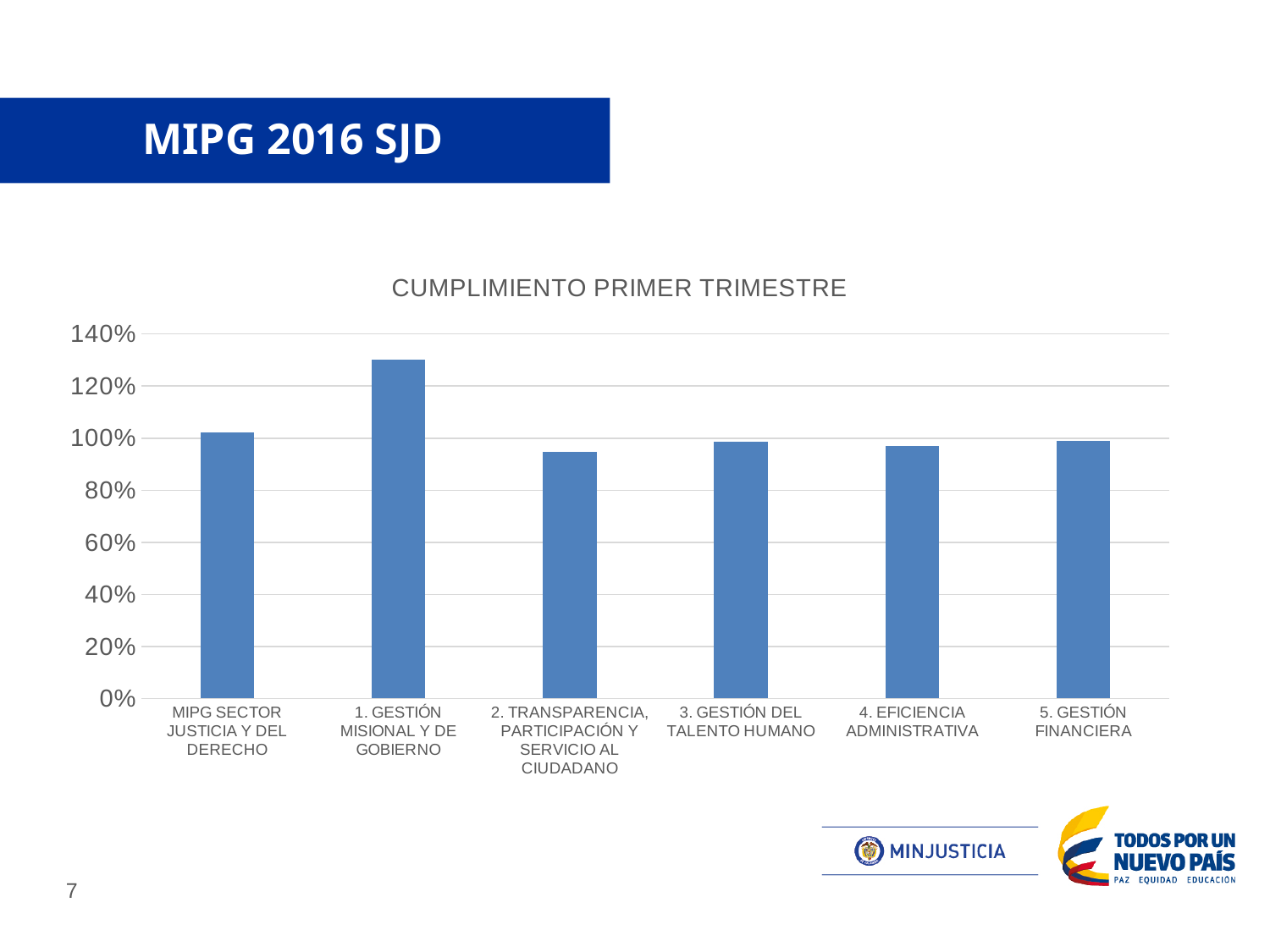
Is the value for 2. TRANSPARENCIA, PARTICIPACIÓN Y SERVICIO AL CIUDADANO greater or less than 100%? less How many categories are plotted in the chart? 6 Which is larger, the value for 1. GESTIÓN MISIONAL Y DE GOBIERNO or the value for 2. TRANSPARENCIA, PARTICIPACIÓN Y SERVICIO AL CIUDADANO? 1. GESTIÓN MISIONAL Y DE GOBIERNO Which category has the highest value in the chart? 1. GESTIÓN MISIONAL Y DE GOBIERNO Is the value for 2. TRANSPARENCIA, PARTICIPACIÓN Y SERVICIO AL CIUDADANO greater or less than 80%? greater Is the value for 1. GESTIÓN MISIONAL Y DE GOBIERNO greater or less than 120%? greater Which is larger, the value for MIPG SECTOR JUSTICIA Y DEL DERECHO or the value for 1. GESTIÓN MISIONAL Y DE GOBIERNO? 1. GESTIÓN MISIONAL Y DE GOBIERNO What kind of chart is shown on the slide? bar chart What is the highest value shown on the vertical axis of the chart? 140% What is the title of the chart? CUMPLIMIENTO PRIMER TRIMESTRE